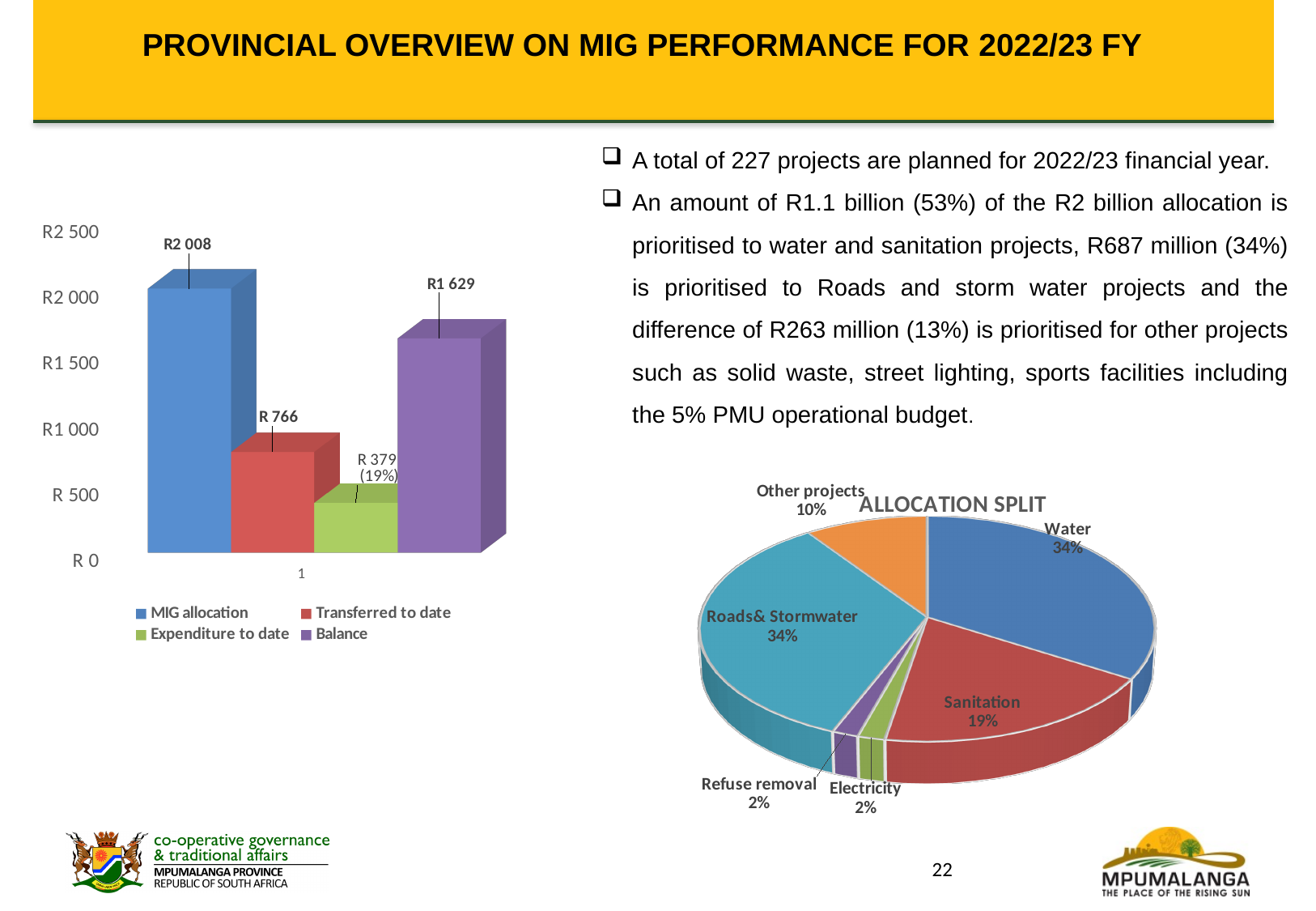
In the bar chart on the left, what is the value for Balance? R1 629 In the bar chart on the left, how many series does the legend list? 4 What kind of chart is the ALLOCATION SPLIT chart? Pie chart In the bar chart on the left, what is the value for MIG allocation? R2 008 In the ALLOCATION SPLIT chart, what share does Sanitation have? 19% In the bar chart on the left, which series has the highest value? MIG allocation In the ALLOCATION SPLIT chart, what share does Other projects have? 10% In the bar chart on the left, what is the value for Transferred to date? R 766 In the ALLOCATION SPLIT chart, how many slices are there? 6 What kind of chart is the chart on the left of the slide? Bar chart In the bar chart on the left, what is the difference between MIG allocation and Balance? R 379 In the bar chart on the left, which series has the lowest value? Expenditure to date